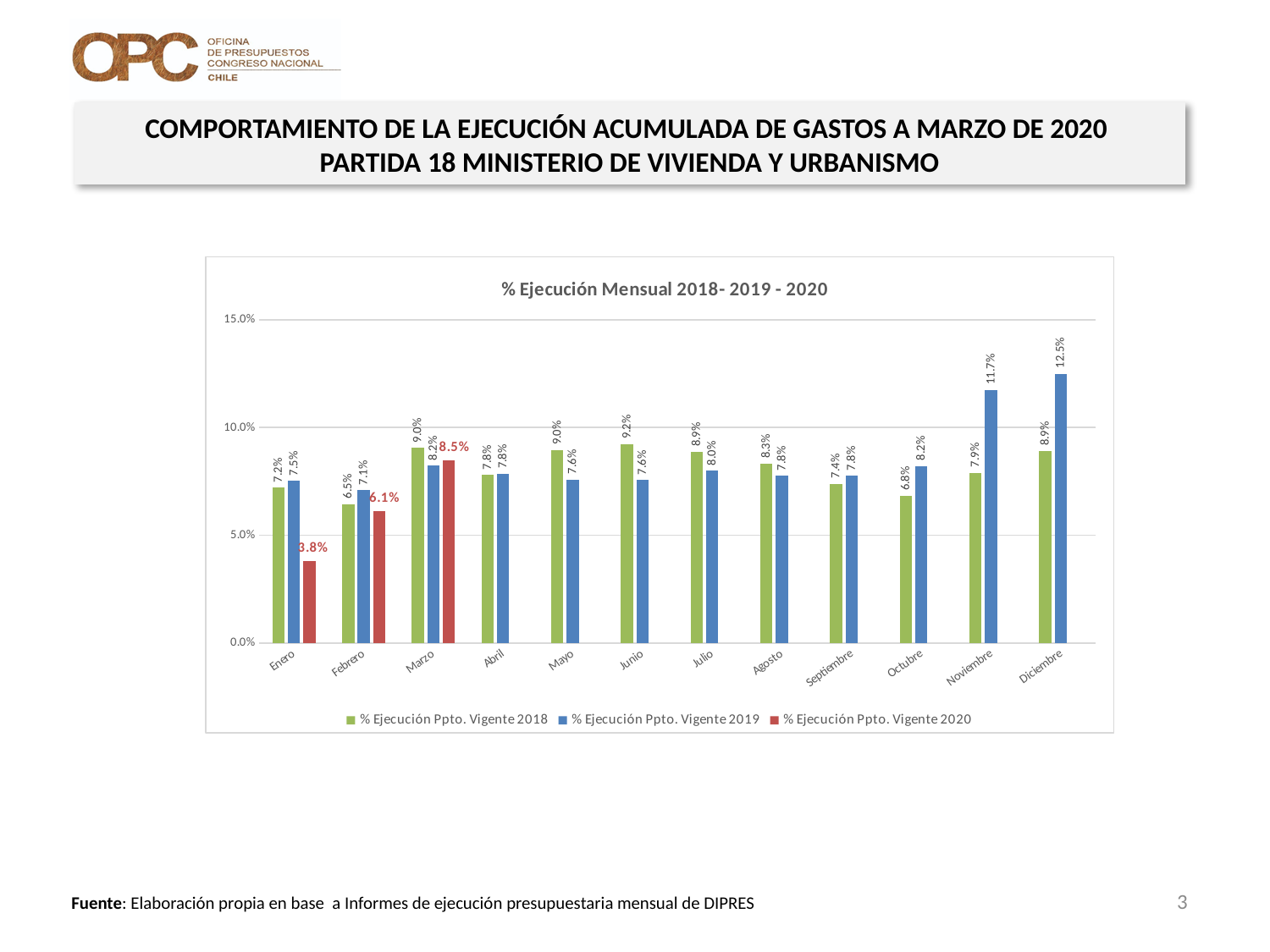
Which month has the highest value for % Ejecución Ppto. Vigente 2019? Diciembre What kind of chart is shown on the slide? Bar chart In Octubre, which series is larger: % Ejecución Ppto. Vigente 2018 or % Ejecución Ppto. Vigente 2019? % Ejecución Ppto. Vigente 2019 Is the value for % Ejecución Ppto. Vigente 2019 in Diciembre greater or less than 10.0%? greater What is the title of the chart? % Ejecución Mensual 2018- 2019 - 2020 How many months are shown on the x axis? 12 How many series does the legend list? 3 Which month has the lowest value for % Ejecución Ppto. Vigente 2018? Febrero What is the difference between the 2019 and 2020 values in Marzo? 0.3% What is the value for % Ejecución Ppto. Vigente 2019 in Noviembre? 11.7% What is the value for % Ejecución Ppto. Vigente 2020 in Enero? 3.8% What is the value for % Ejecución Ppto. Vigente 2018 in Junio? 9.2%